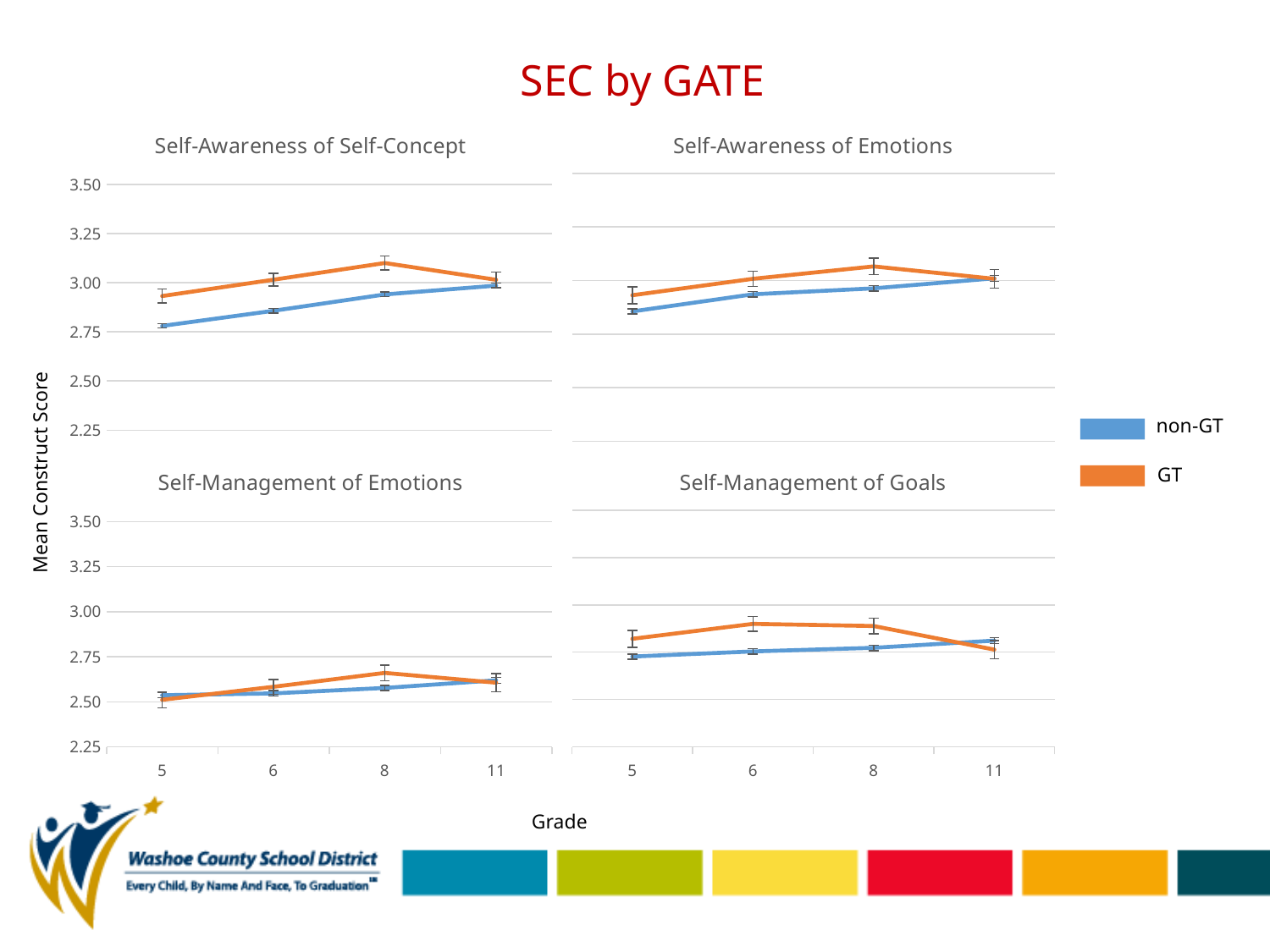
What kind of chart is used in the Self-Awareness of Self-Concept panel? Line chart How many series does the legend list? 2 In the Self-Awareness of Self-Concept chart, does the non-GT line rise or fall from grade 5 to grade 11? rise In the Self-Awareness of Self-Concept chart, at which grade is the GT line highest? 8 What is the label on the shared y axis of the charts? Mean Construct Score In the Self-Management of Emotions chart, is the GT value at grade 8 greater or less than 2.75? less In the Self-Awareness of Self-Concept chart, is the GT value at grade 8 greater or less than 3.00? greater In the Self-Awareness of Self-Concept chart, at which grade is the non-GT line lowest? 5 How many grade levels are plotted along the x axis of the Self-Management of Goals chart? 4 In the Self-Awareness of Self-Concept chart, is the non-GT value at grade 8 greater or less than 3.00? less In the Self-Awareness of Self-Concept chart, which group has the higher value at grade 8, GT or non-GT? GT